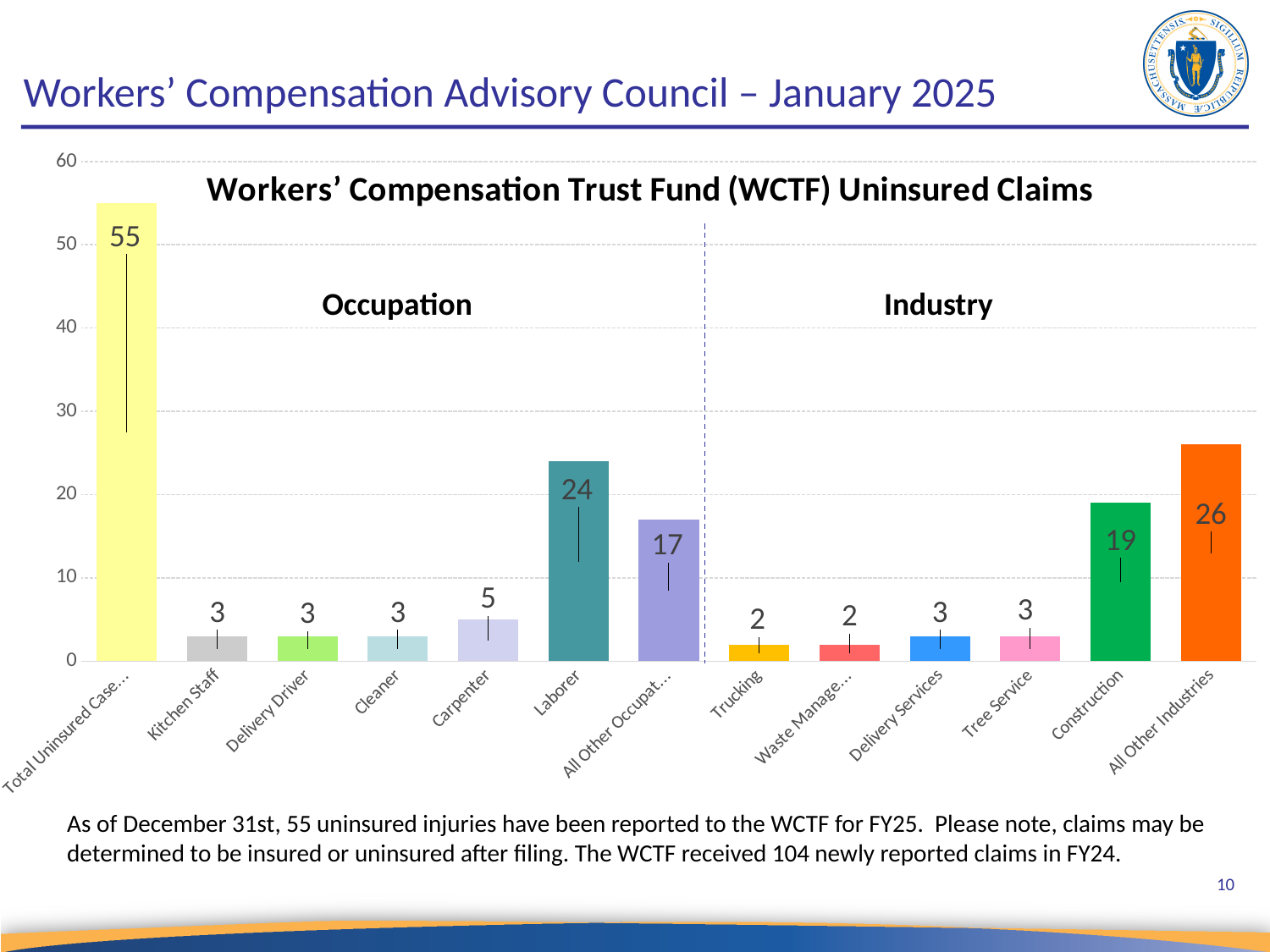
What is the value for Laborer? 24 Among the Industry categories, which has the highest value? All Other Industries What kind of chart is shown on the slide? Bar chart Which category has the highest value? Total Uninsured Cases Which is larger, the value for All Other Industries or the value for Laborer? All Other Industries What is the value for Trucking? 2 Is the value for Total Uninsured Cases greater or less than 50? greater What is the value for Construction? 19 What is the value for Carpenter? 5 What is the title of the chart? Workers' Compensation Trust Fund (WCTF) Uninsured Claims How many bars are plotted in the chart? 13 What is the difference between the values for Laborer and Construction? 5